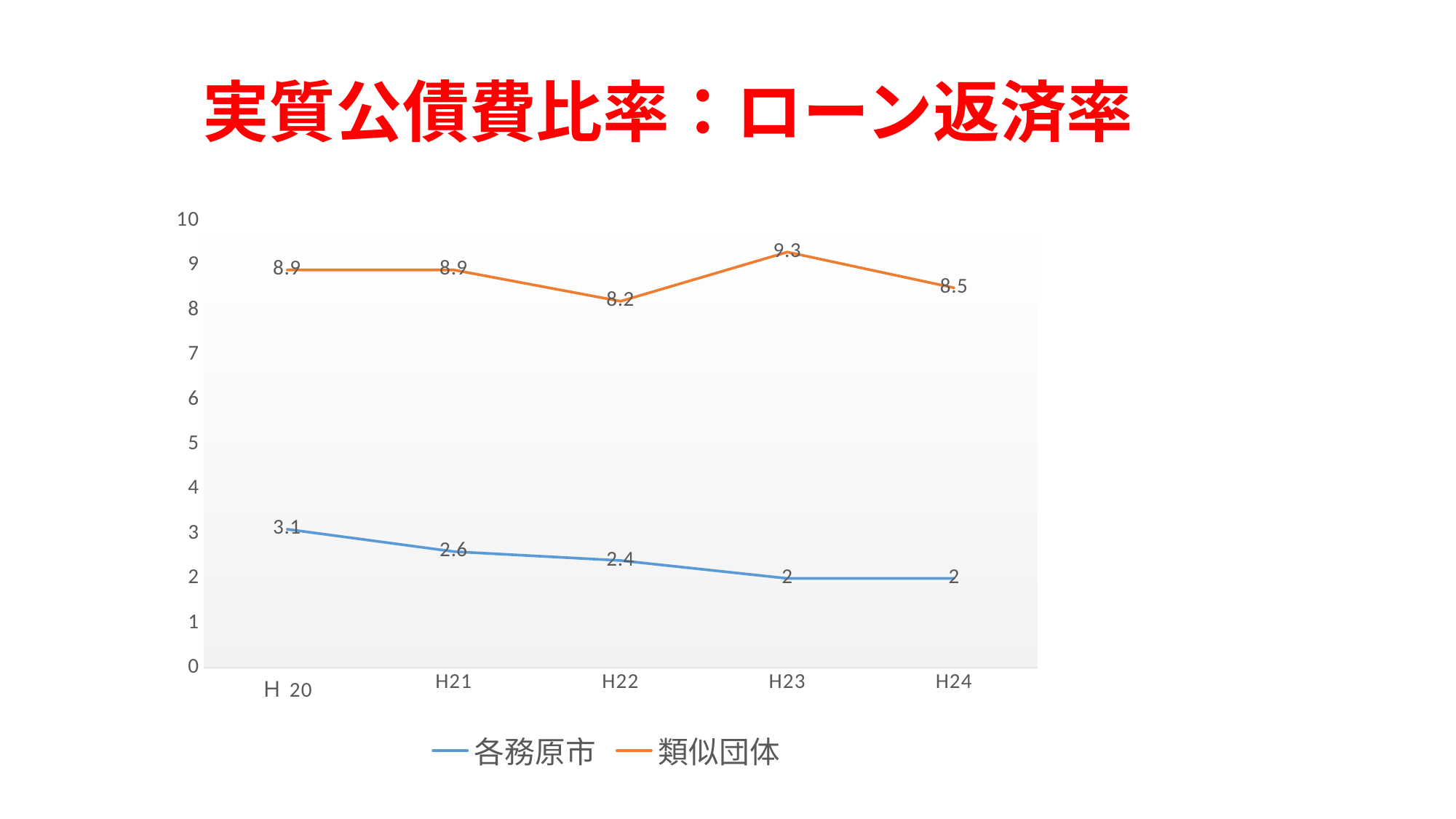
What is the difference between 類似団体 and 各務原市 in H21? 6.3 How many series does the legend list? 2 How many years are shown on the x axis? 5 In which year is the value for 類似団体 lowest? H22 What is the value for 類似団体 in H23? 9.3 Which series has the larger value in H24, 各務原市 or 類似団体? 類似団体 In which year is the value for 類似団体 highest? H23 What is the value for 類似団体 in H22? 8.2 Does the value for 各務原市 rise or fall from H20 to H23? fall What is the value for 各務原市 in H20? 3.1 What kind of chart is shown on the slide? line chart What is the value for 各務原市 in H24? 2